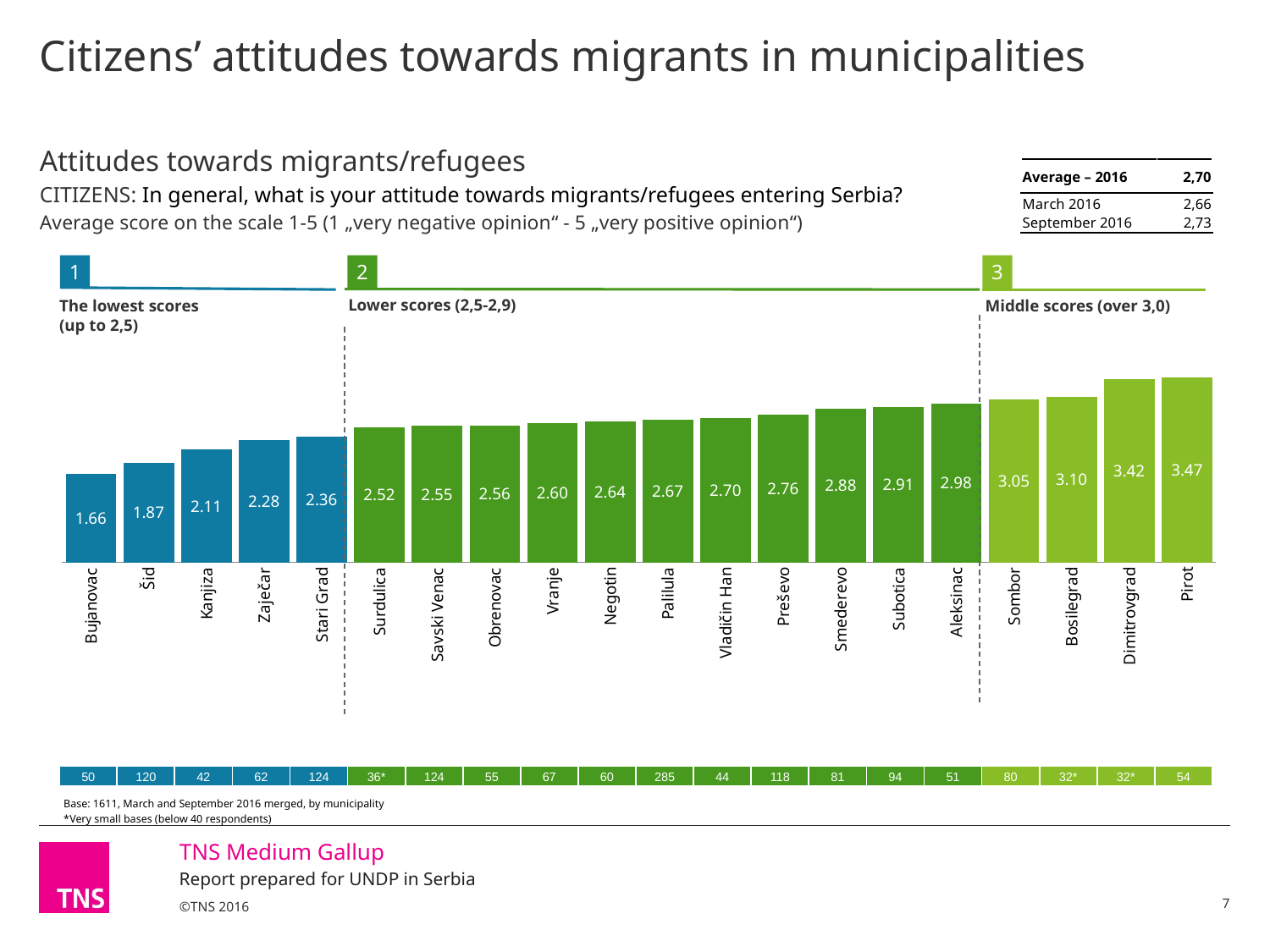
Which municipality has the lowest average attitude score? Bujanovac What is the average attitude score for Subotica? 2.91 What is the difference between the scores for Dimitrovgrad and Sombor? 0.37 What kind of chart is used to show the municipality scores? Bar chart How many municipalities are shown in the chart? 20 What is the average attitude score for Bujanovac? 1.66 Which has a higher average attitude score, Smederevo or Negotin? Smederevo What is the difference between the scores for Pirot and Bujanovac? 1.81 What is the average attitude score for Vladičin Han? 2.70 What is the average attitude score for Pirot? 3.47 Which municipality has the highest average attitude score? Pirot Do the scores rise or fall from left to right across the municipalities? Rise